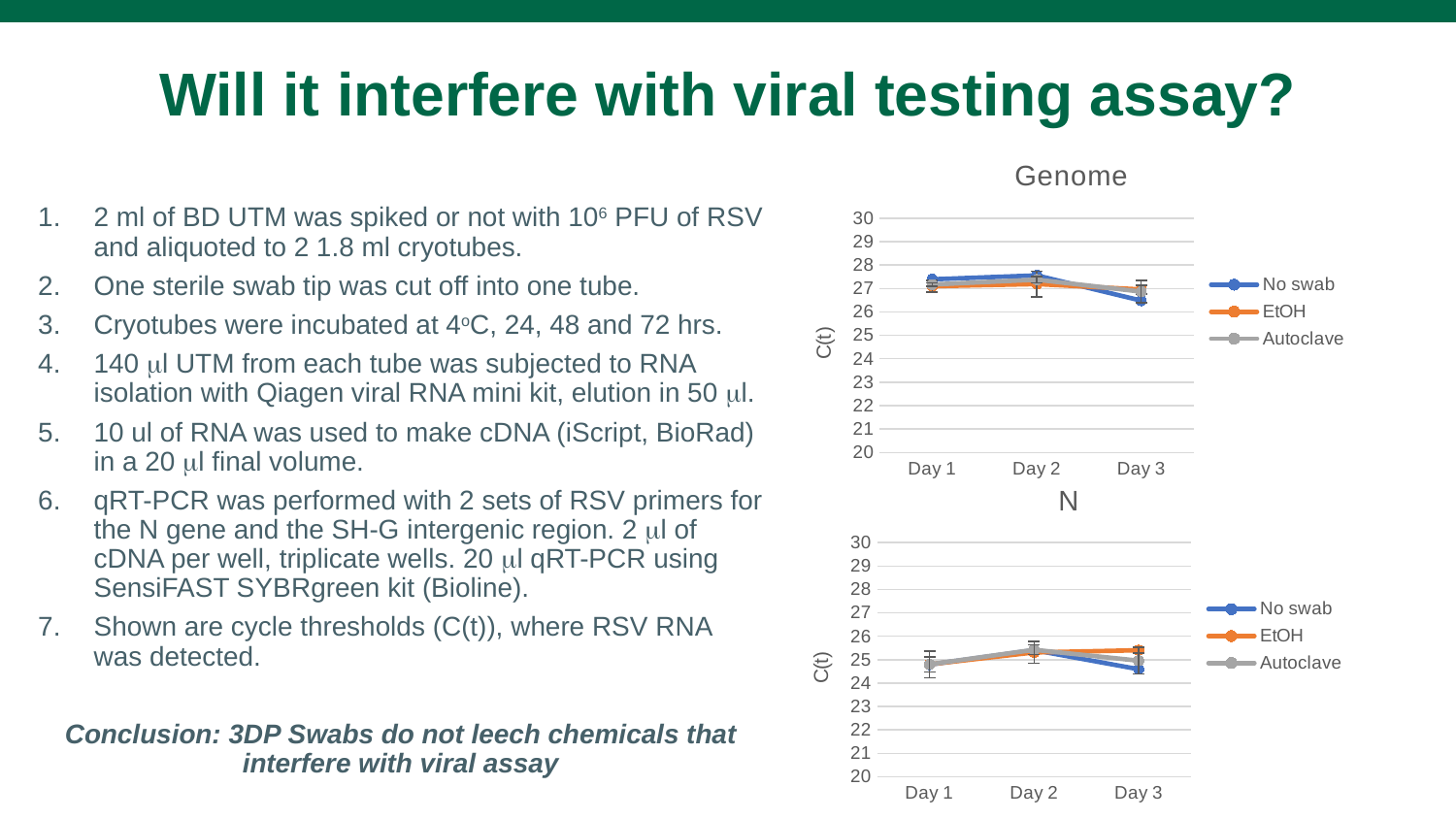
In the "N" chart, is the value for Autoclave on Day 2 greater or less than 27? less How many series does the legend of the "N" chart list? 3 How many categories are shown on the x axis of the "Genome" chart? 3 In the "Genome" chart, is the value for EtOH on Day 3 greater or less than 29? less In the "N" chart, is the value for EtOH on Day 3 greater or less than 23? greater How many series does the legend of the "Genome" chart list? 3 In the "Genome" chart, does the No swab line rise or fall from Day 2 to Day 3? fall What is the y-axis label of the "N" chart? C(t) How many categories are shown on the x axis of the "N" chart? 3 What kind of chart is the chart titled "N"? line chart What kind of chart is the chart titled "Genome"? line chart